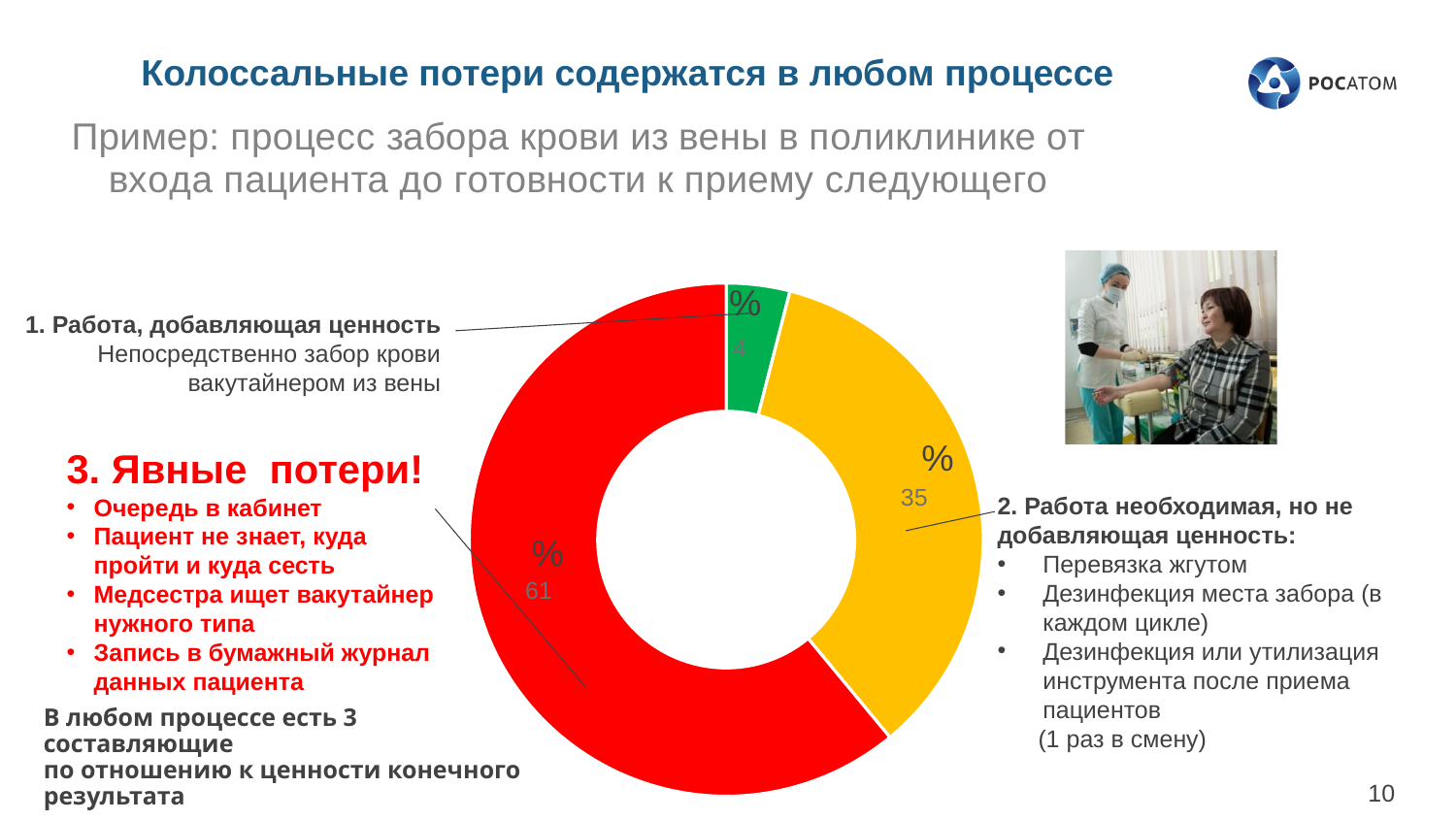
Which category has the largest slice of the pie chart? 3. Явные потери! What is the sum of the three percentages shown on the pie chart? 100 Which is larger: the slice for "Работа, добавляющая ценность" or the slice for "Работа необходимая, но не добавляющая ценность"? Работа необходимая, но не добавляющая ценность What is the difference in percentage points between the "Явные потери" slice and the "Работа необходимая, но не добавляющая ценность" slice? 26 What percentage is shown for the slice labelled "1. Работа, добавляющая ценность"? 4% What kind of chart is shown on the slide? Pie chart (donut) What percentage is shown for the slice labelled "2. Работа необходимая, но не добавляющая ценность"? 35% What colour is the largest slice of the pie chart? Red Which category has the smallest slice of the pie chart? 1. Работа, добавляющая ценность What percentage is shown for the slice labelled "3. Явные потери!"? 61% What colour is the slice representing "1. Работа, добавляющая ценность"? Green How many slices does the pie chart have? 3